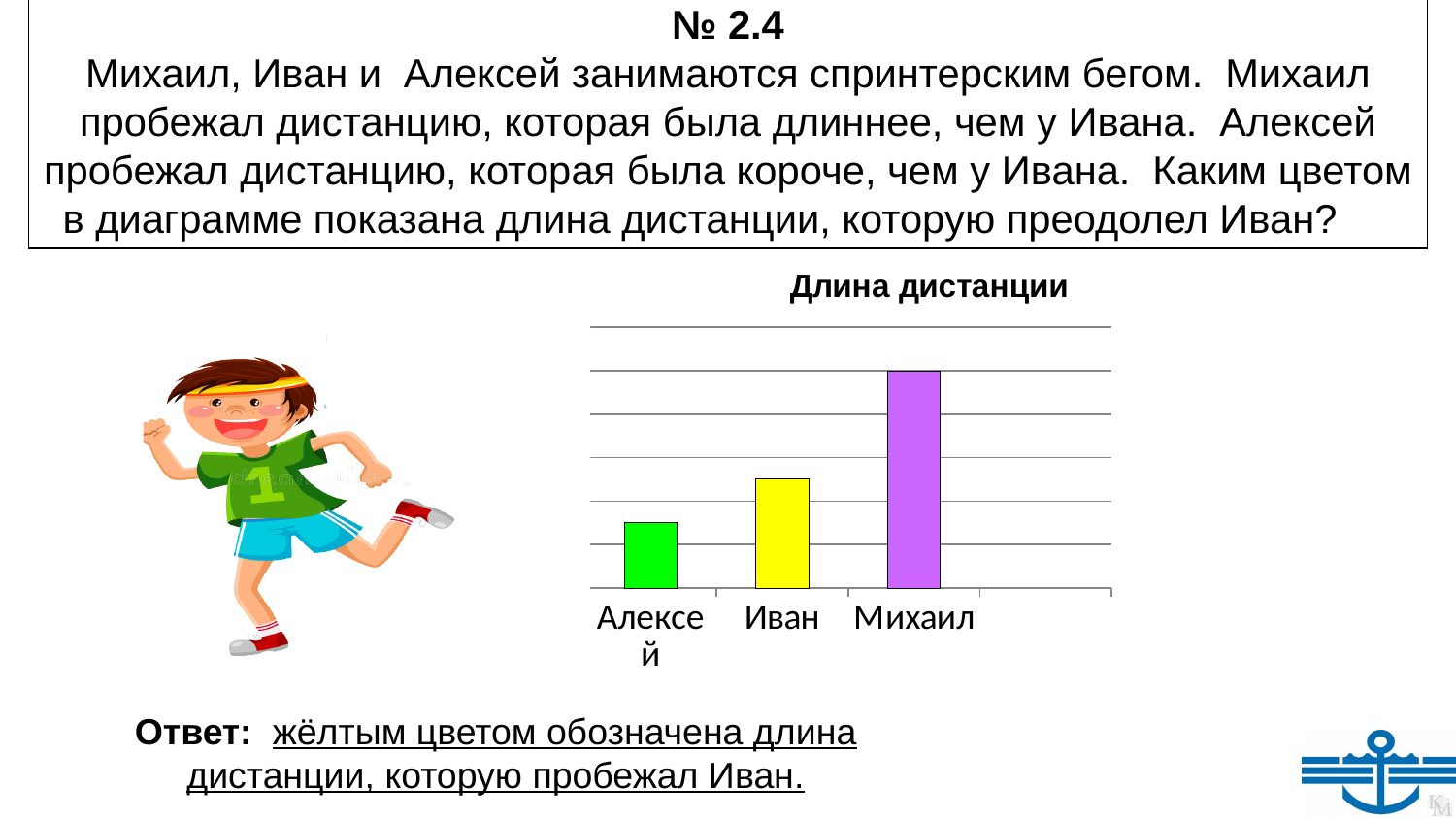
What kind of chart is shown on the slide? bar chart Which category has the lowest bar in the chart? Алексей What is the title of the chart? Длина дистанции Which bar is taller, Михаил or Иван? Михаил Which bar is taller, Иван or Алексей? Иван Which category has the highest bar in the chart? Михаил Do the bar heights rise or fall from left to right along the x axis? rise How many categories are shown on the x axis of the chart? 3 What colour is the bar for Иван? yellow